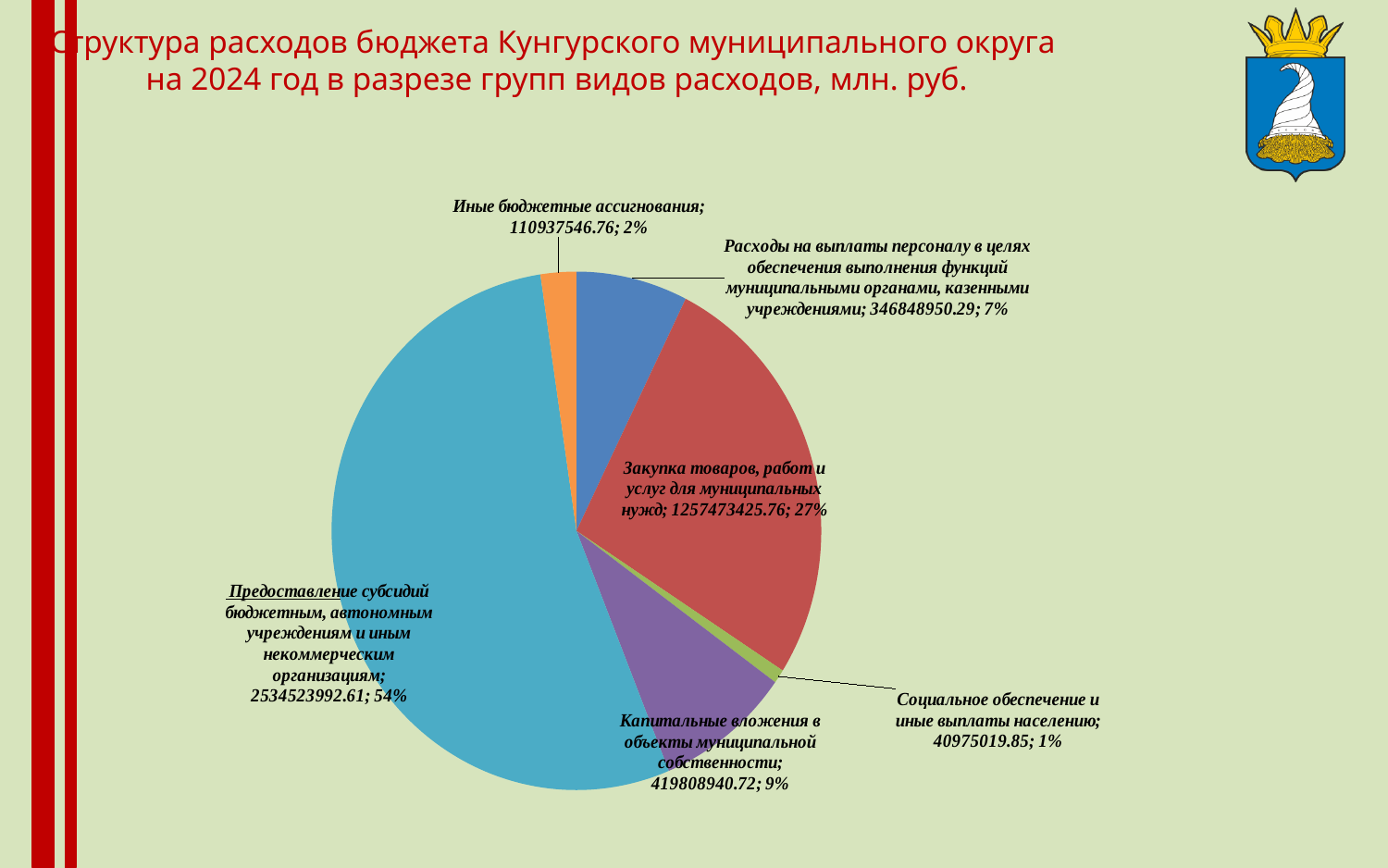
What is the difference in percentage points between «Закупка товаров, работ и услуг для муниципальных нужд» (27%) and «Капитальные вложения в объекты муниципальной собственности» (9%)? 18 percentage points What is the title of the slide? Структура расходов бюджета Кунгурского муниципального округа на 2024 год в разрезе групп видов расходов, млн. руб. Which is larger: «Расходы на выплаты персоналу...» or «Капитальные вложения в объекты муниципальной собственности»? Капитальные вложения в объекты муниципальной собственности What value is shown for «Закупка товаров, работ и услуг для муниципальных нужд»? 1257473425.76 What share of the pie does «Предоставление субсидий бюджетным, автономным учреждениям и иным некоммерческим организациям» have? 54% What value is shown for «Социальное обеспечение и иные выплаты населению»? 40975019.85 What percentage is shown for «Иные бюджетные ассигнования»? 2% How many slices does the pie chart have? 6 Which category has the largest slice of the pie? Предоставление субсидий бюджетным, автономным учреждениям и иным некоммерческим организациям What value is shown for «Капитальные вложения в объекты муниципальной собственности»? 419808940.72 Which category has the smallest slice of the pie? Социальное обеспечение и иные выплаты населению What kind of chart is shown on the slide? pie chart